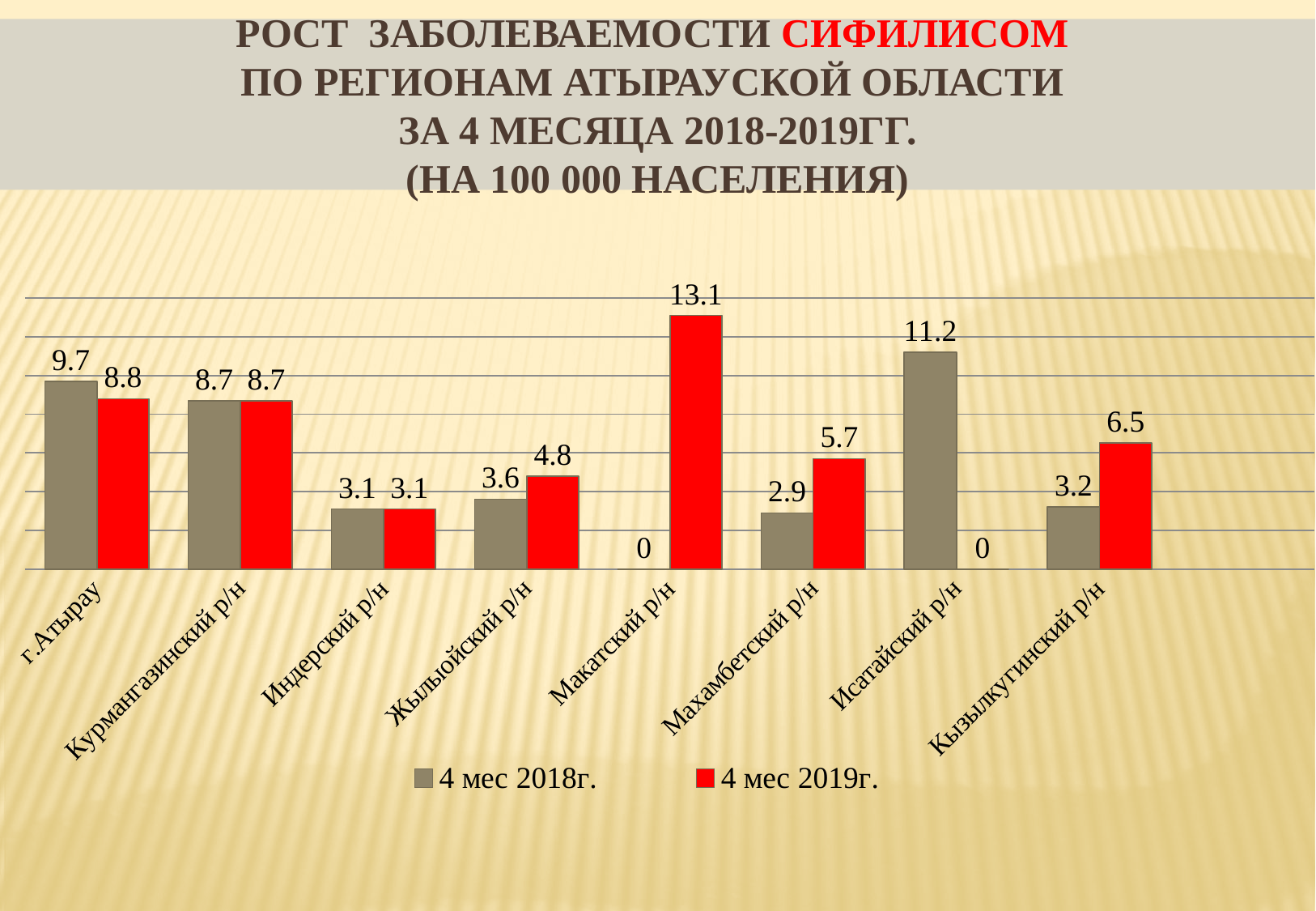
What is the value for г.Атырау in the series "4 мес 2019г."? 8.8 How many series does the legend list? 2 What is the difference between the 2019 and 2018 values for Кызылкугинский р/н? 3.3 Which region has the lowest value in the series "4 мес 2018г."? Макатский р/н For Махамбетский р/н, which series has the larger value, "4 мес 2018г." or "4 мес 2019г."? 4 мес 2019г. How many regions (categories) are shown on the x axis? 8 What type of chart is shown on the slide? Bar chart What is the value for Исатайский р/н in the series "4 мес 2018г."? 11.2 What is the value for Макатский р/н in the series "4 мес 2019г."? 13.1 Which region has the highest value in the series "4 мес 2018г."? Исатайский р/н Which region has the highest value in the series "4 мес 2019г."? Макатский р/н What colour are the bars for the series "4 мес 2019г."? Red